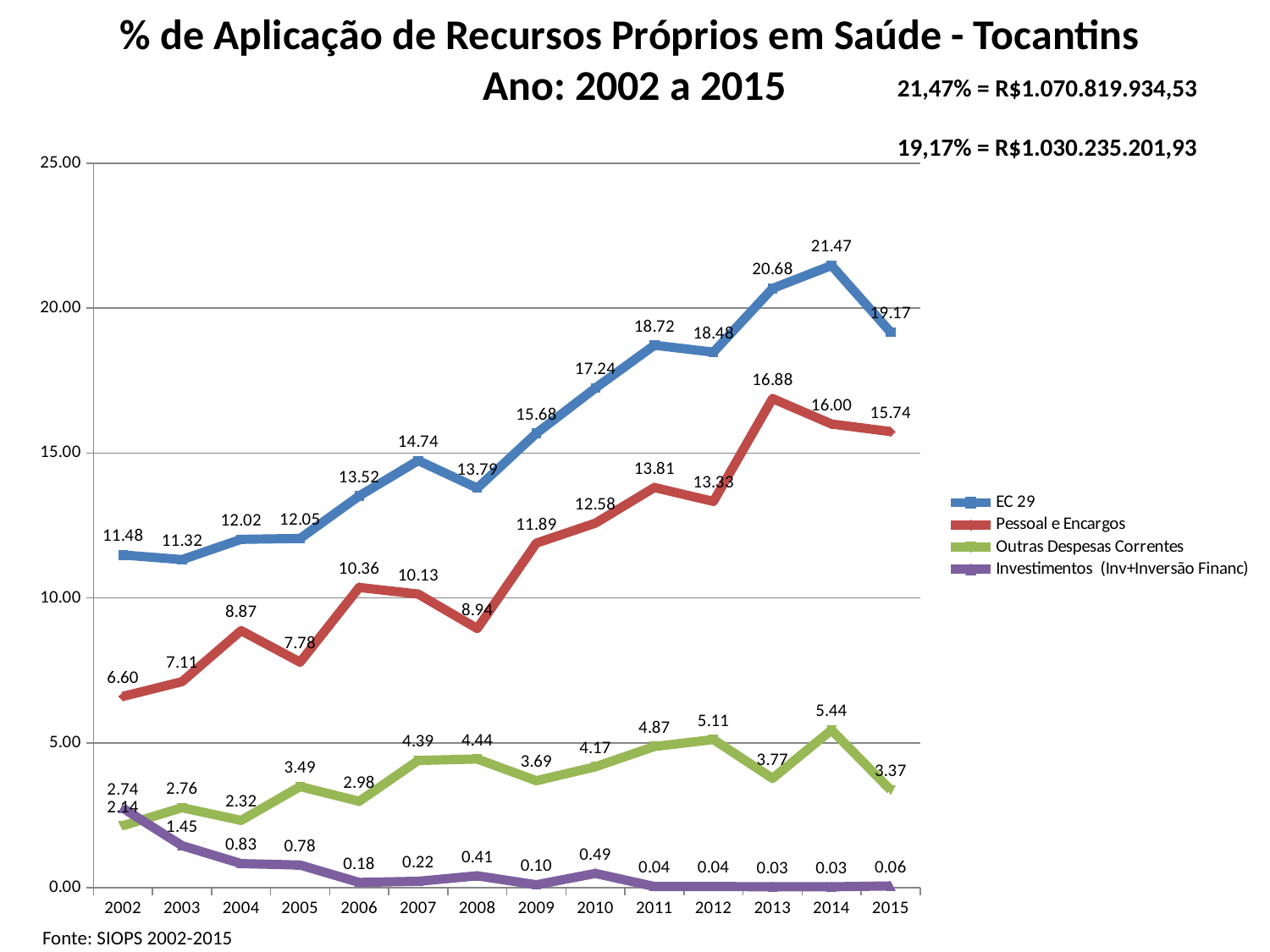
How many series does the legend list? 4 What is the value of Pessoal e Encargos in 2013? 16.88 What is the value of EC 29 in 2014? 21.47 Which is larger: Outras Despesas Correntes in 2012 or in 2013? 2012 What kind of chart is shown on the slide? Line chart What is the value of Outras Despesas Correntes in 2014? 5.44 In which year is Pessoal e Encargos at its lowest? 2002 What is the difference between the EC 29 values in 2014 and 2015? 2.30 How many years are shown on the x axis? 14 In which year does EC 29 reach its highest value? 2014 Is the value of EC 29 in 2013 greater or less than 20.00? greater What is the value of Investimentos (Inv+Inversão Financ) in 2010? 0.49